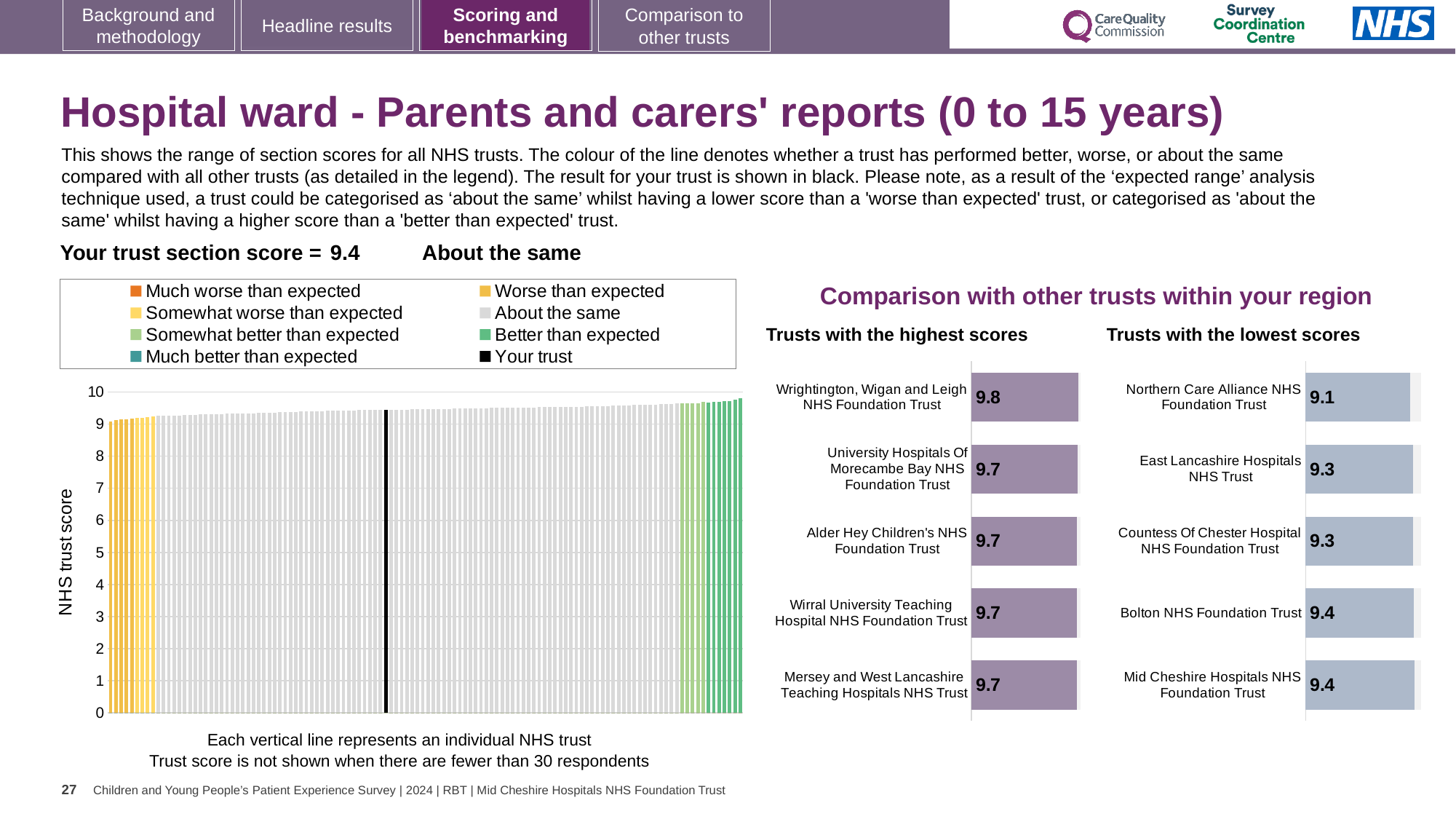
In the left-hand chart, do the trust scores rise or fall from left to right along the x axis? Rise What kind of chart is the large chart on the left showing NHS trust scores? Bar chart What is the y-axis label of the left-hand chart? NHS trust score In the 'Trusts with the lowest scores' chart, what is the difference between the scores of Bolton NHS Foundation Trust and Northern Care Alliance NHS Foundation Trust? 0.3 How many trusts are shown in the 'Trusts with the highest scores' chart? 5 How many entries does the legend above the left-hand chart list? 8 In the 'Trusts with the highest scores' chart, which trust has the highest score? Wrightington, Wigan and Leigh NHS Foundation Trust In the 'Trusts with the highest scores' chart, what is the score for Wrightington, Wigan and Leigh NHS Foundation Trust? 9.8 In the 'Trusts with the lowest scores' chart, what is the score for Northern Care Alliance NHS Foundation Trust? 9.1 In the 'Trusts with the lowest scores' chart, what is the score for Mid Cheshire Hospitals NHS Foundation Trust? 9.4 In the 'Trusts with the lowest scores' chart, which trust has the lowest score? Northern Care Alliance NHS Foundation Trust In the 'Trusts with the lowest scores' chart, which has the larger score: East Lancashire Hospitals NHS Trust or Bolton NHS Foundation Trust? Bolton NHS Foundation Trust